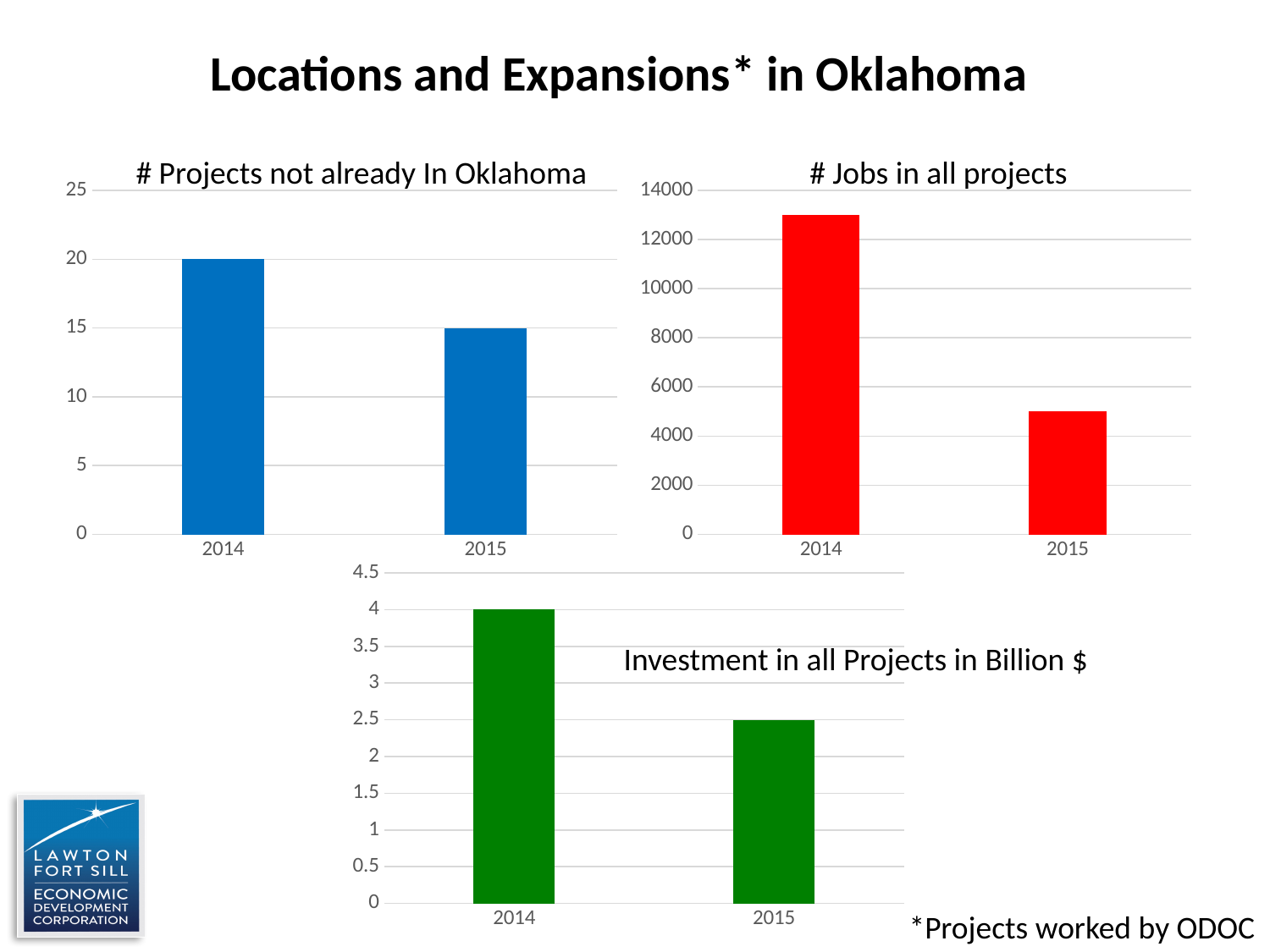
In the 'Investment in all Projects in Billion $' chart, what is the value for 2014? 4 In the '# Projects not already In Oklahoma' chart, what is the value for 2014? 20 In the '# Projects not already In Oklahoma' chart, what is the value for 2015? 15 In the 'Investment in all Projects in Billion $' chart, what is the value for 2015? 2.5 In the '# Jobs in all projects' chart, is the value for 2015 greater or less than 6000? less In the '# Projects not already In Oklahoma' chart, what is the difference between the 2014 and 2015 values? 5 In the 'Investment in all Projects in Billion $' chart, do the values rise or fall from 2014 to 2015? fall In the '# Jobs in all projects' chart, is the value for 2014 greater or less than 12000? greater What type of chart is the '# Projects not already In Oklahoma' chart? bar chart In the 'Investment in all Projects in Billion $' chart, which year has the lower value? 2015 How many categories are shown on the x axis of the '# Jobs in all projects' chart? 2 In the '# Jobs in all projects' chart, which year has the higher value? 2014